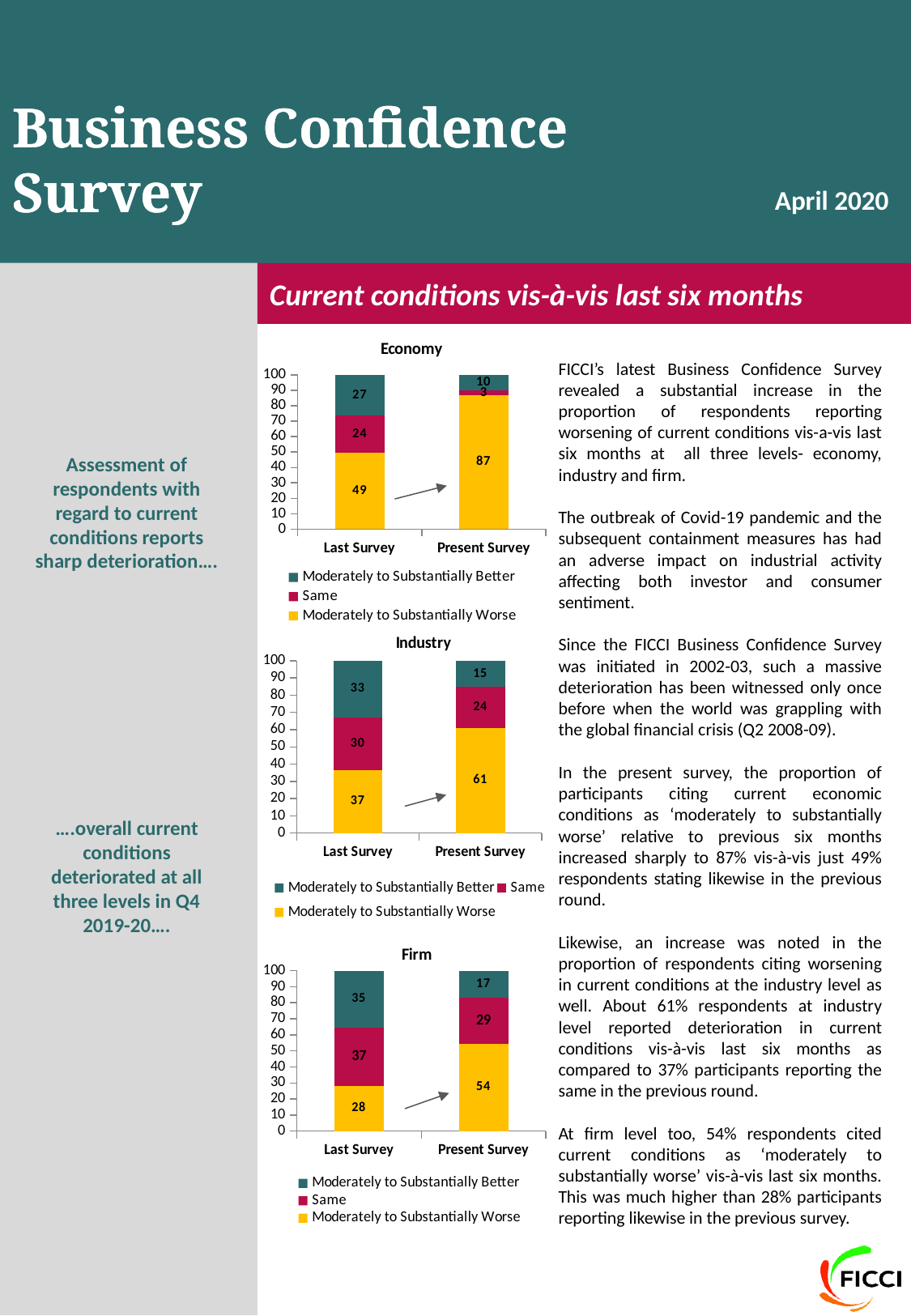
How many series does the legend of the Industry chart list? 3 In the Economy chart, what is the value for Same in the Last Survey? 24 How many categories are shown on the x axis of the Economy chart? 2 In the Economy chart, which series is shown in yellow? Moderately to Substantially Worse What kind of chart is the Firm chart? Stacked bar chart In the Firm chart, what is the value for Moderately to Substantially Worse in the Last Survey? 28 In the Firm chart, what is the difference between the Moderately to Substantially Worse values for the Present Survey and the Last Survey? 26 In the Firm chart, what is the total of the stacked bar for the Present Survey? 100 In the Industry chart, what is the value for Moderately to Substantially Better in the Present Survey? 15 In the Economy chart, what is the value for Moderately to Substantially Worse in the Present Survey? 87 In the Industry chart, what is the difference between the Moderately to Substantially Worse values for the Present Survey and the Last Survey? 24 In the Economy chart, which is larger: the Same value in the Last Survey or the Same value in the Present Survey? Last Survey